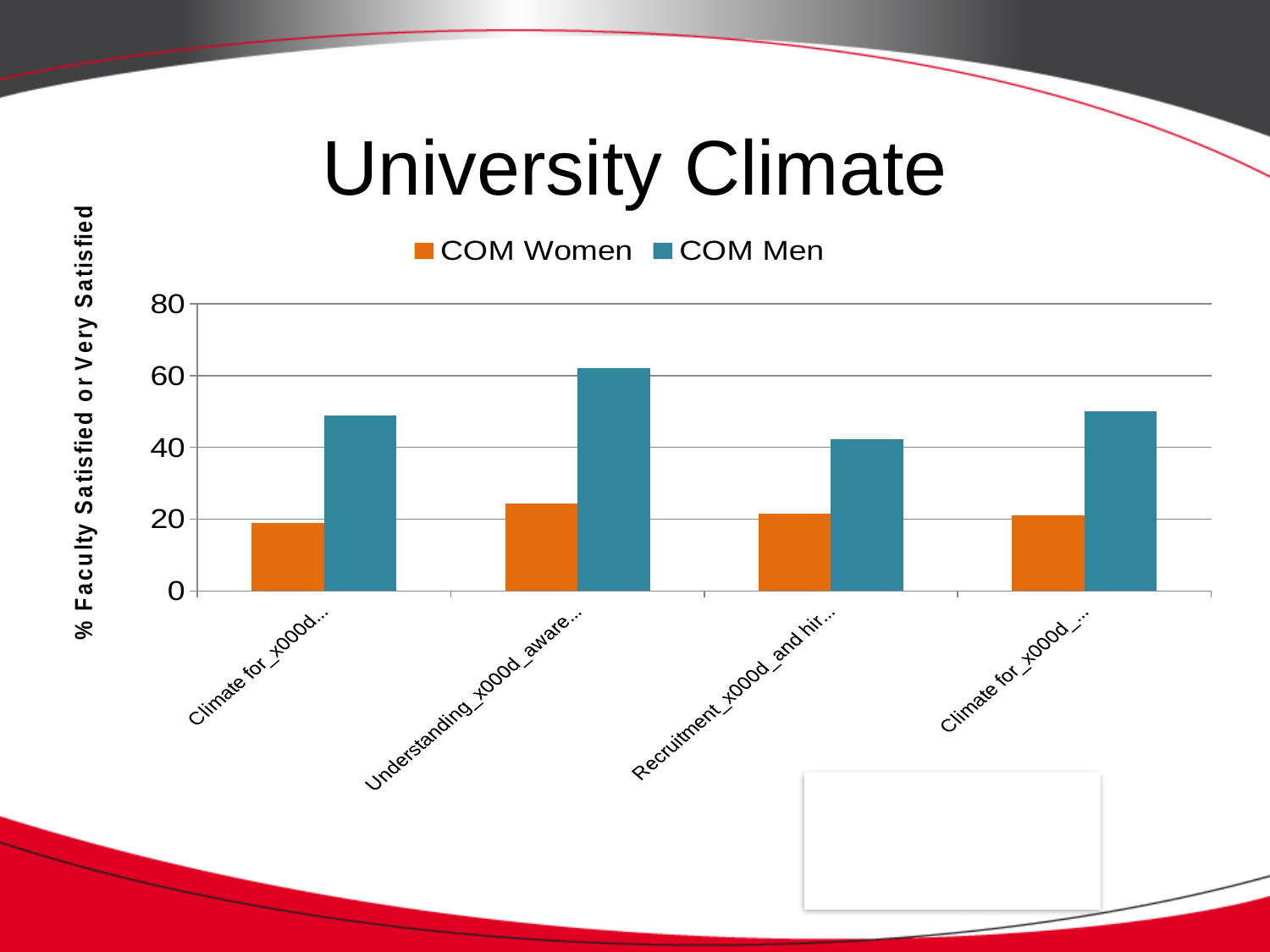
In the first category, which series has the larger value, COM Women or COM Men? COM Men For which category is the COM Men value highest? Understanding_x000d_aware... (the second category) How many series does the legend list? 2 Is the COM Men value for the Understanding category greater or less than 40? greater Is the COM Women value for the Understanding category greater or less than 40? less What kind of chart is shown on the slide? bar chart For which category is the COM Men value lowest? Recruitment_x000d_and hir... (the third category) In the Recruitment category, which series has the larger value, COM Women or COM Men? COM Men What is the title of the y axis? % Faculty Satisfied or Very Satisfied How many categories are plotted along the x axis? 4 Is the COM Men value for the first category greater or less than 40? greater What are the two series named in the legend? COM Women and COM Men